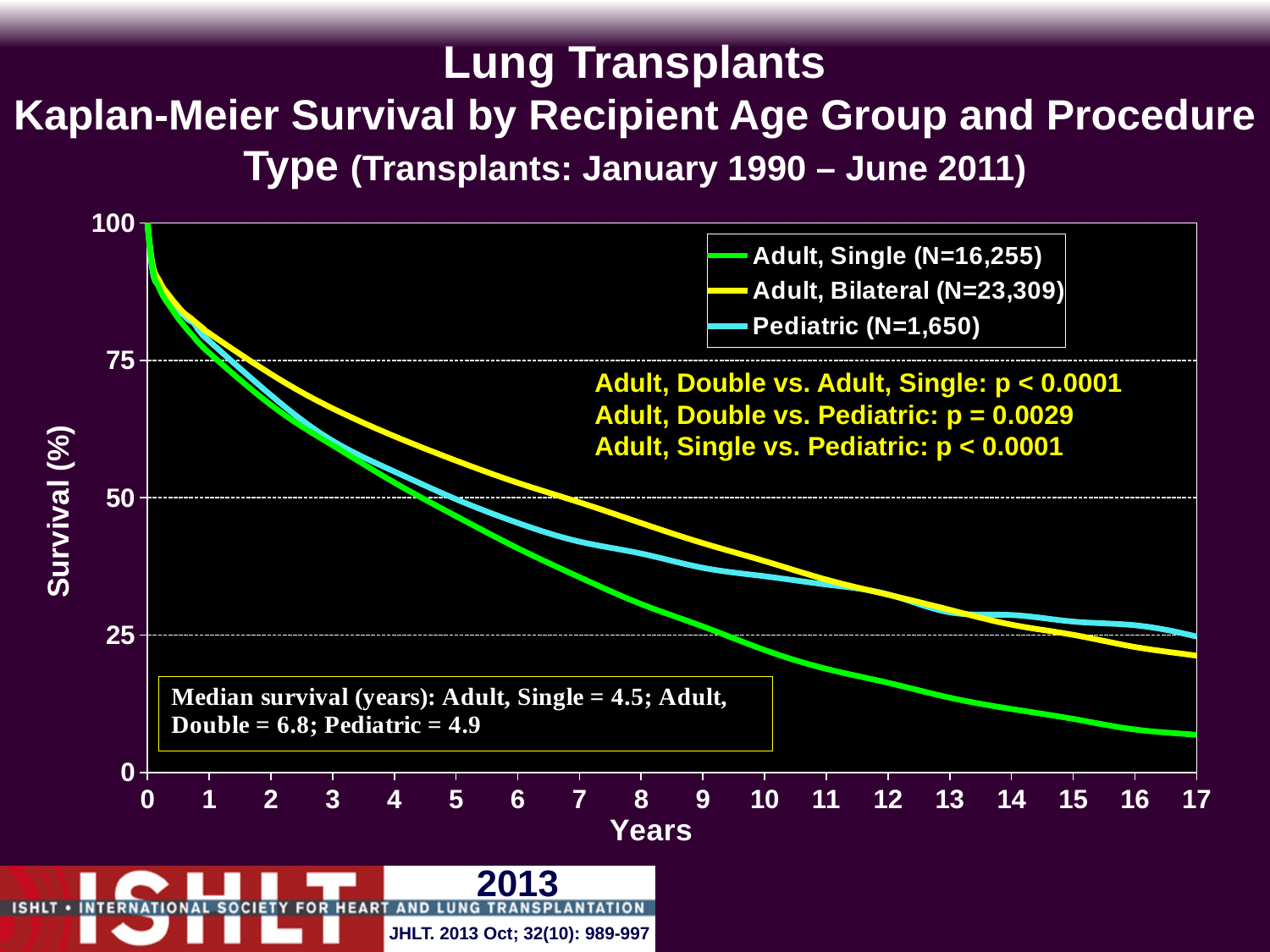
What is the difference in median survival (years) between Adult, Double and Adult, Single? 2.3 Which group has the lowest survival at 17 years? Adult, Single Do the survival curves rise or fall as years increase? fall What kind of chart is shown on the slide? line chart Which group has the highest survival at 5 years? Adult, Bilateral Is the survival for Adult, Single at 10 years greater or less than 25%? less How many series does the legend list? 3 What is the median survival in years for Adult, Single recipients? 4.5 Which group has the longer median survival, Adult, Double or Pediatric? Adult, Double What is the median survival in years for Pediatric recipients? 4.9 What is the median survival in years for Adult, Double recipients? 6.8 What is the N for the Adult, Bilateral group shown in the legend? 23,309